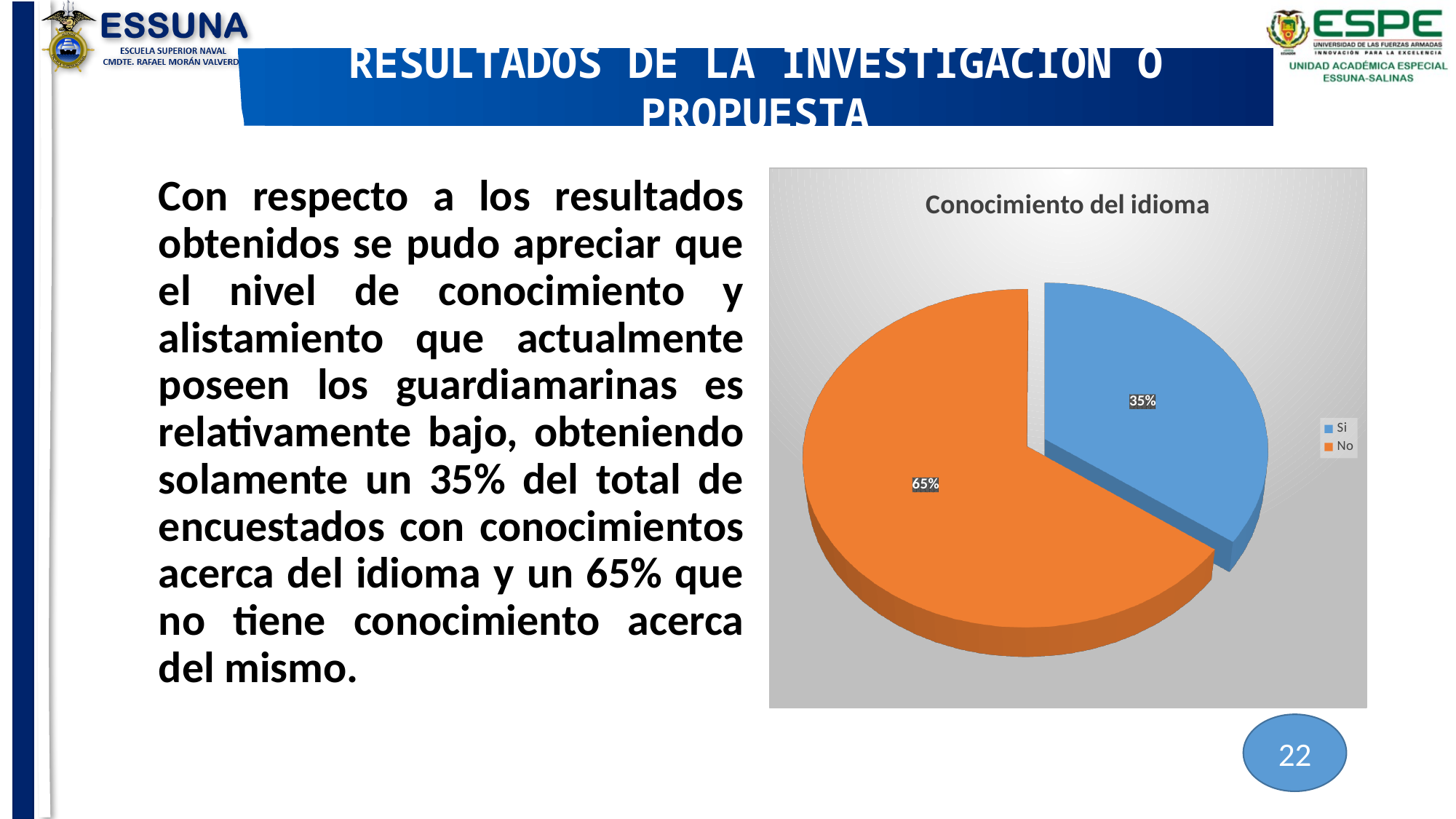
What kind of chart is shown on the slide? pie chart What percentage does the 'No' slice represent? 65% How many entries does the legend list? 2 What colour is the 'No' slice? orange Which category has the smallest share of the pie? Si How many slices does the pie chart have? 2 What is the title of the chart? Conocimiento del idioma Which category has the largest share of the pie? No What share of the pie does the 'Si' slice take? 35% Which slice is larger, 'Si' or 'No'? No What percentage does the 'Si' slice represent? 35% What is the difference in percentage points between the 'No' and 'Si' slices? 30%